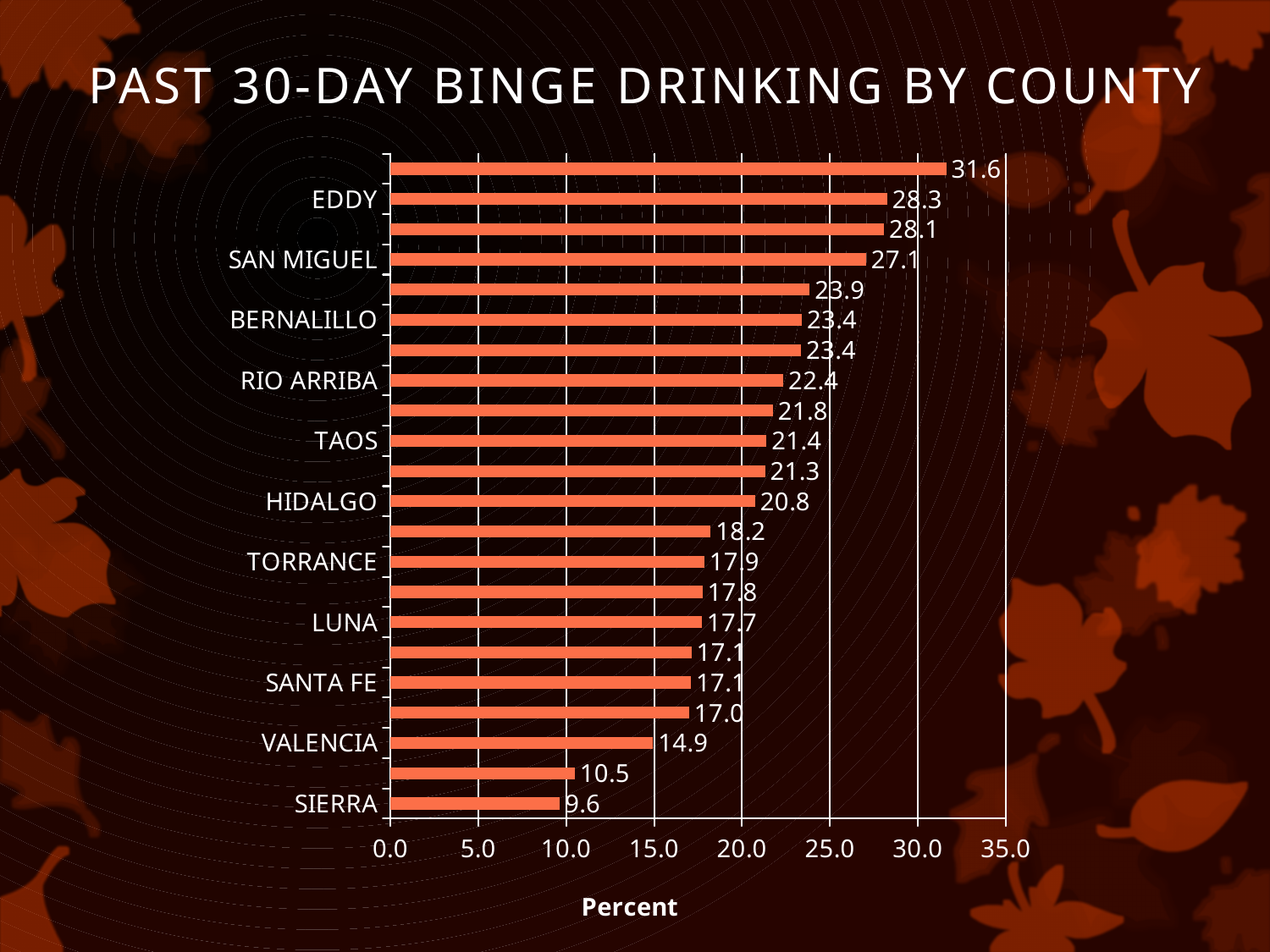
Is the value for LUNA greater or less than 20.0? less What value is shown for SAN MIGUEL? 27.1 Which labeled county has the lowest binge drinking percentage? SIERRA How many bars are plotted in the chart? 22 What is the value for TAOS? 21.4 What is the title of the horizontal axis? Percent What is the value for BERNALILLO? 23.4 Which has a higher value, RIO ARRIBA or HIDALGO? RIO ARRIBA What is the difference between the values for EDDY and SANTA FE? 11.2 What is the value for VALENCIA? 14.9 What is the past 30-day binge drinking percentage for EDDY county? 28.3 What type of chart is shown on the slide? bar chart